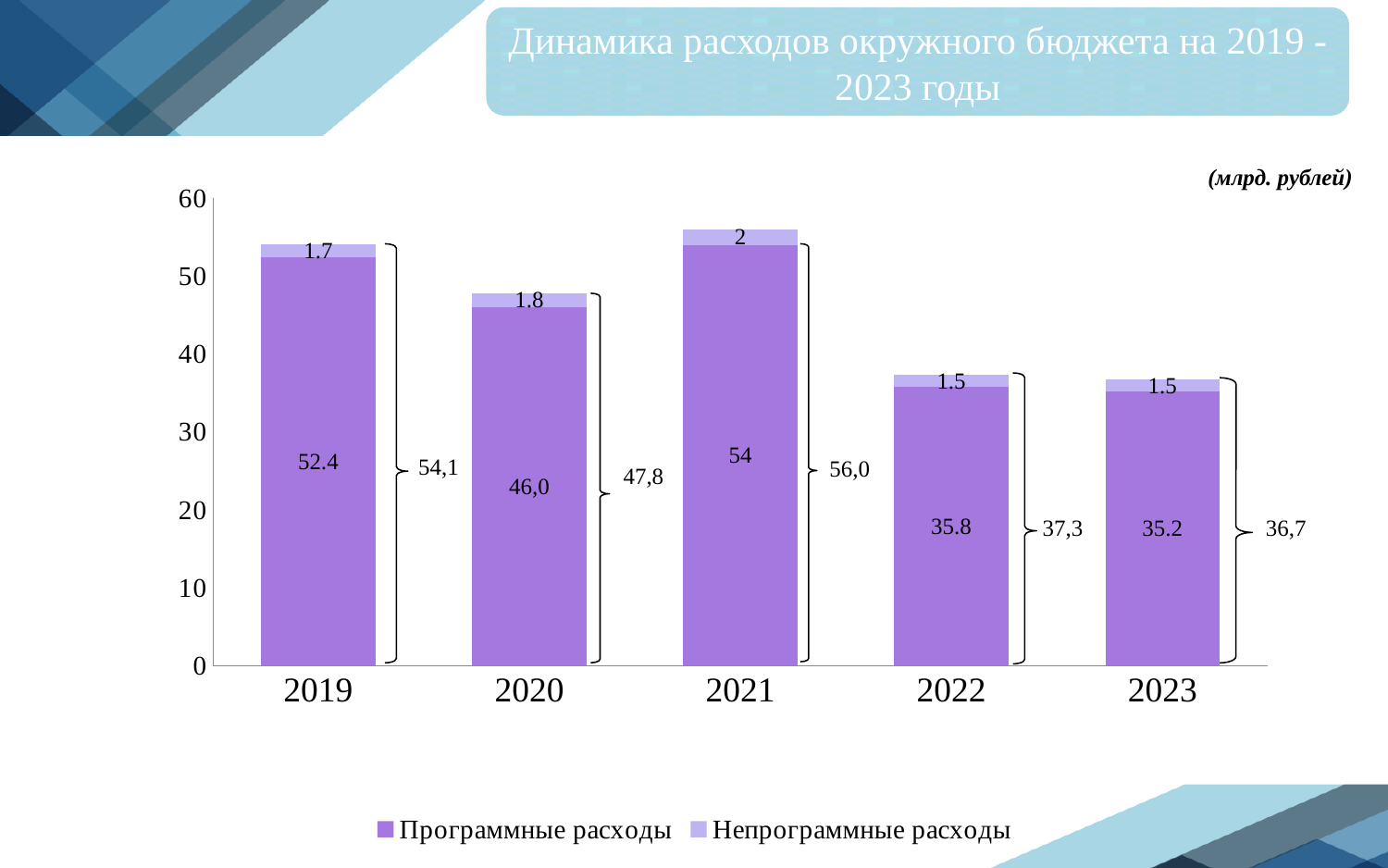
How many years are shown on the x axis? 5 Which year has the highest value for Программные расходы? 2021 What is the value of Программные расходы for 2023? 35.2 What is the difference between Программные расходы in 2021 and 2022? 18.2 What is the value of Непрограммные расходы for 2021? 2 Which year has the lowest value for Программные расходы? 2023 What is the value of Программные расходы for 2019? 52.4 Which is larger: Непрограммные расходы in 2020 or in 2022? 2020 What is the total of the stacked bar for 2020? 47,8 How many series does the legend list? 2 Do the total expenditures rise or fall from 2021 to 2023? Fall What type of chart is shown on the slide? Stacked bar chart